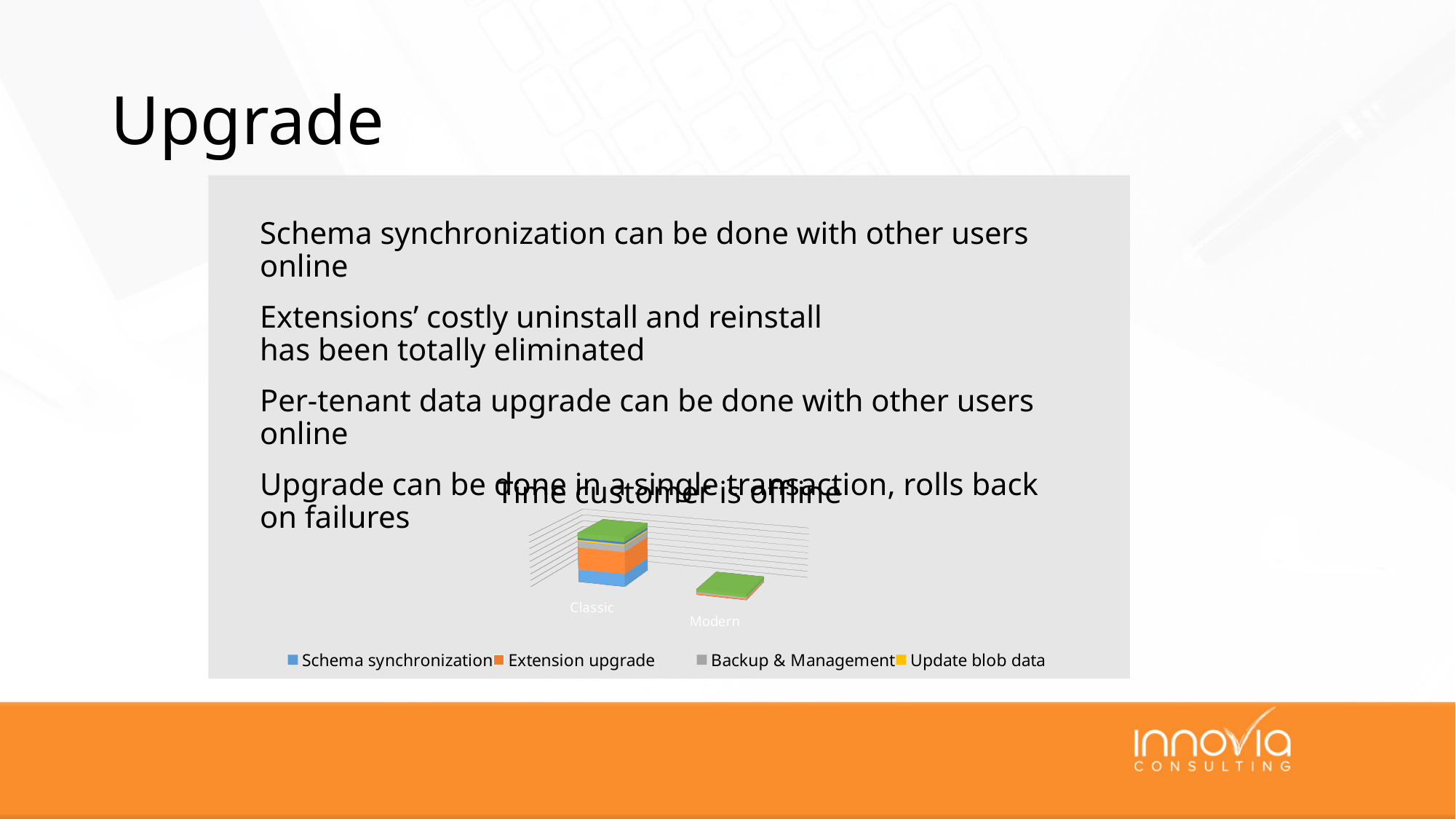
Which category has the highest total bar in the chart? Classic How many series does the chart legend list? 4 What kind of chart is shown on the slide? Stacked bar chart What are the two categories shown on the x axis of the chart? Classic and Modern Which category has the lowest total bar in the chart? Modern How many categories are shown on the x axis of the chart? 2 Which series is shown in blue in the chart legend? Schema synchronization Which category has the taller stacked bar, Classic or Modern? Classic Which series is shown in orange in the chart legend? Extension upgrade